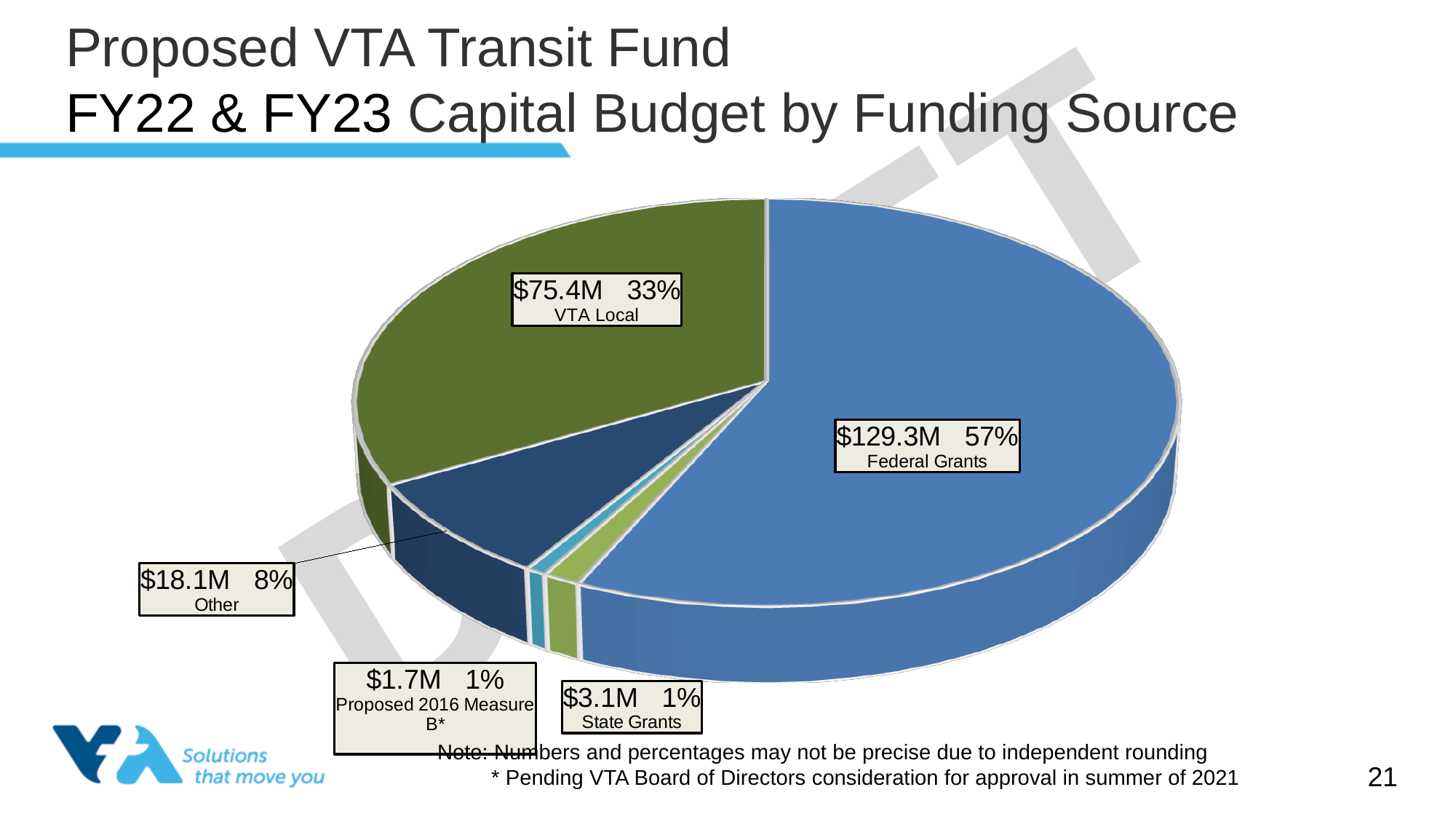
What is the dollar amount for State Grants? $3.1M What is the dollar amount for Proposed 2016 Measure B*? $1.7M How many funding sources are shown in the pie chart? 5 What is the difference in dollars between Federal Grants and VTA Local? $53.9M What is the dollar amount for VTA Local? $75.4M What share of the capital budget comes from VTA Local? 33% What share of the capital budget comes from Federal Grants? 57% What is the dollar amount for Federal Grants? $129.3M Which funding source is the largest? Federal Grants Which funding source is the smallest? Proposed 2016 Measure B* What type of chart is shown on the slide? Pie chart What is the dollar amount for Other? $18.1M